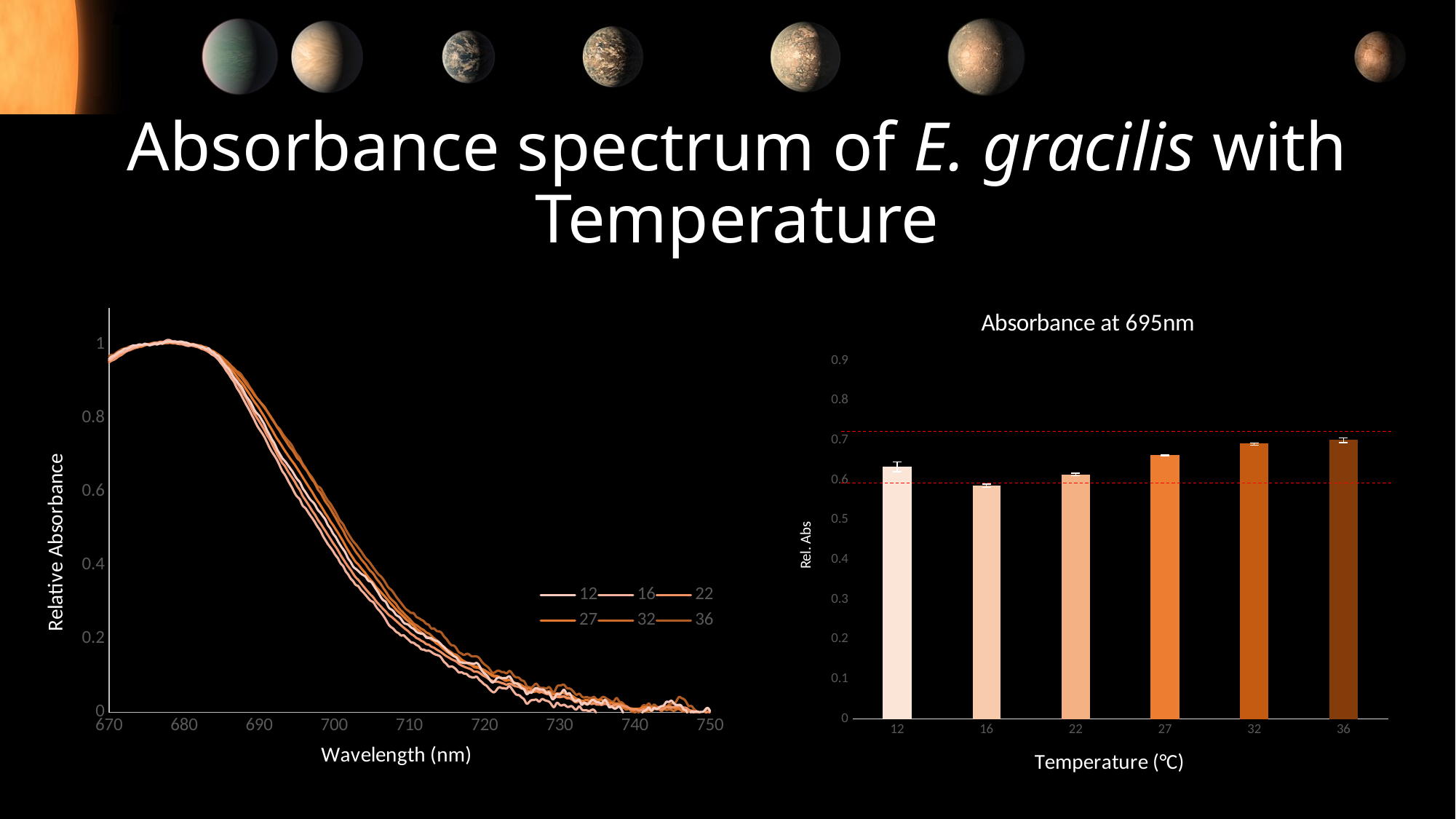
What is the x-axis label of the left chart? Wavelength (nm) In the 'Absorbance at 695nm' chart, which is larger, the value for 22 °C or the value for 32 °C? 32 °C In the left chart, do the curves rise or fall as wavelength increases from 690 nm to 750 nm? fall How many bars are in the 'Absorbance at 695nm' chart? 6 What kind of chart is the 'Absorbance at 695nm' chart? bar chart What kind of chart is the chart on the left of the slide? line chart In the 'Absorbance at 695nm' chart, is the value for 27 °C greater or less than 0.6? greater In the 'Absorbance at 695nm' chart, is the value for 16 °C greater or less than 0.6? less In the 'Absorbance at 695nm' chart, which temperature has the lowest absorbance? 16 How many series does the legend of the left chart list? 6 In the 'Absorbance at 695nm' chart, which is larger, the value for 12 °C or the value for 16 °C? 12 °C In the 'Absorbance at 695nm' chart, is the value for 36 °C greater or less than 0.8? less